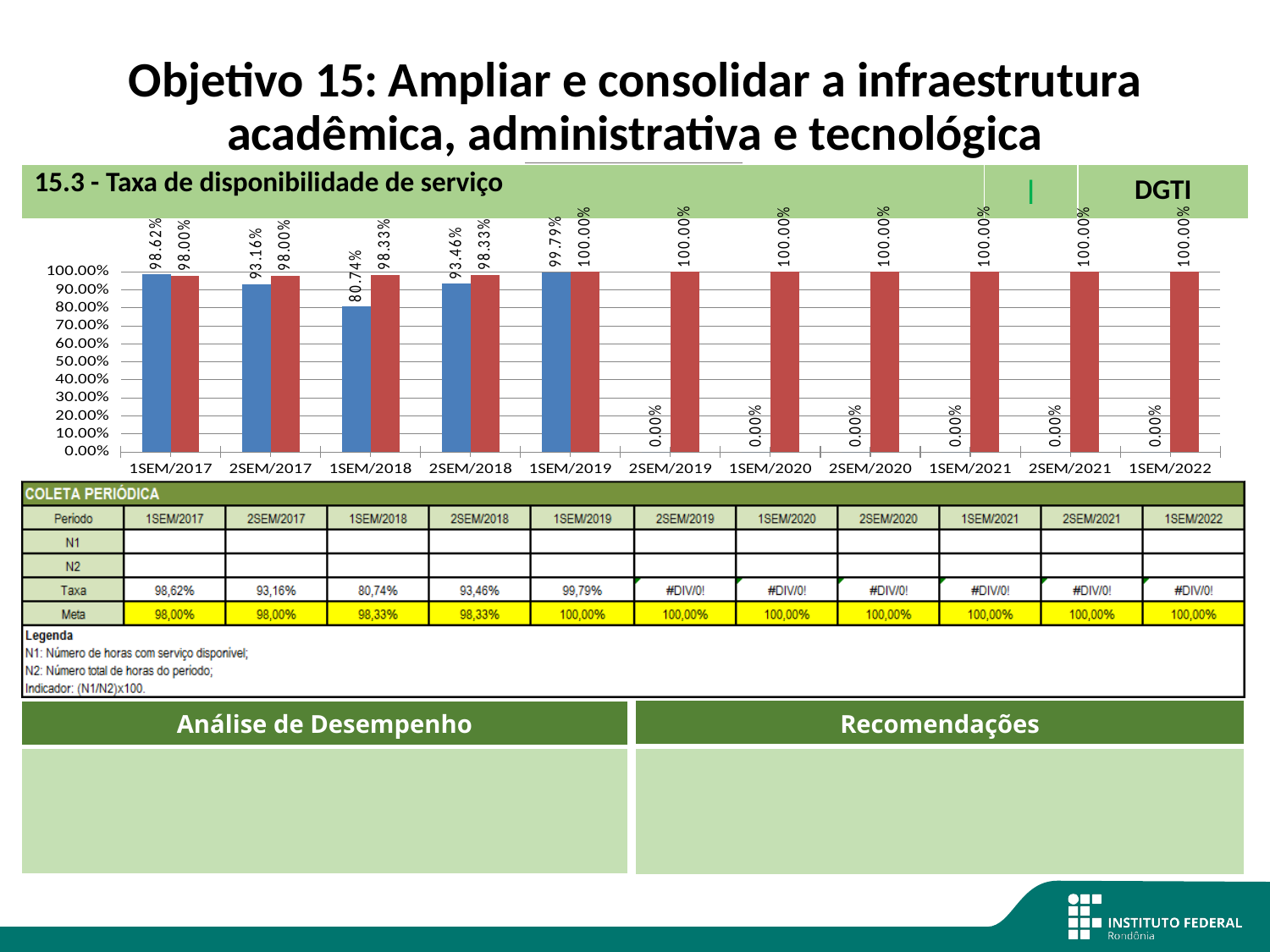
What kind of chart is shown on the slide? bar chart Which period has the highest blue bar (Taxa)? 1SEM/2019 Among the periods from 1SEM/2017 to 1SEM/2019, which has the lowest blue bar (Taxa)? 1SEM/2018 What is the value of the red bar (Meta) for 1SEM/2019? 100.00% What is the value of the red bar (Meta) for 2SEM/2017? 98.00% What is the value of the blue bar (Taxa) for 1SEM/2019? 99.79% For 1SEM/2017, which is larger: the blue bar (Taxa) or the red bar (Meta)? the blue bar (Taxa) How many periods are shown on the x axis of the chart? 11 What is the value of the blue bar (Taxa) for 1SEM/2018? 80.74% Is the blue bar (Taxa) for 1SEM/2018 greater or less than 90.00%? less What is the title of the chart? 15.3 - Taxa de disponibilidade de serviço By how many percentage points does the red bar (Meta) exceed the blue bar (Taxa) for 1SEM/2018? 17.59 percentage points